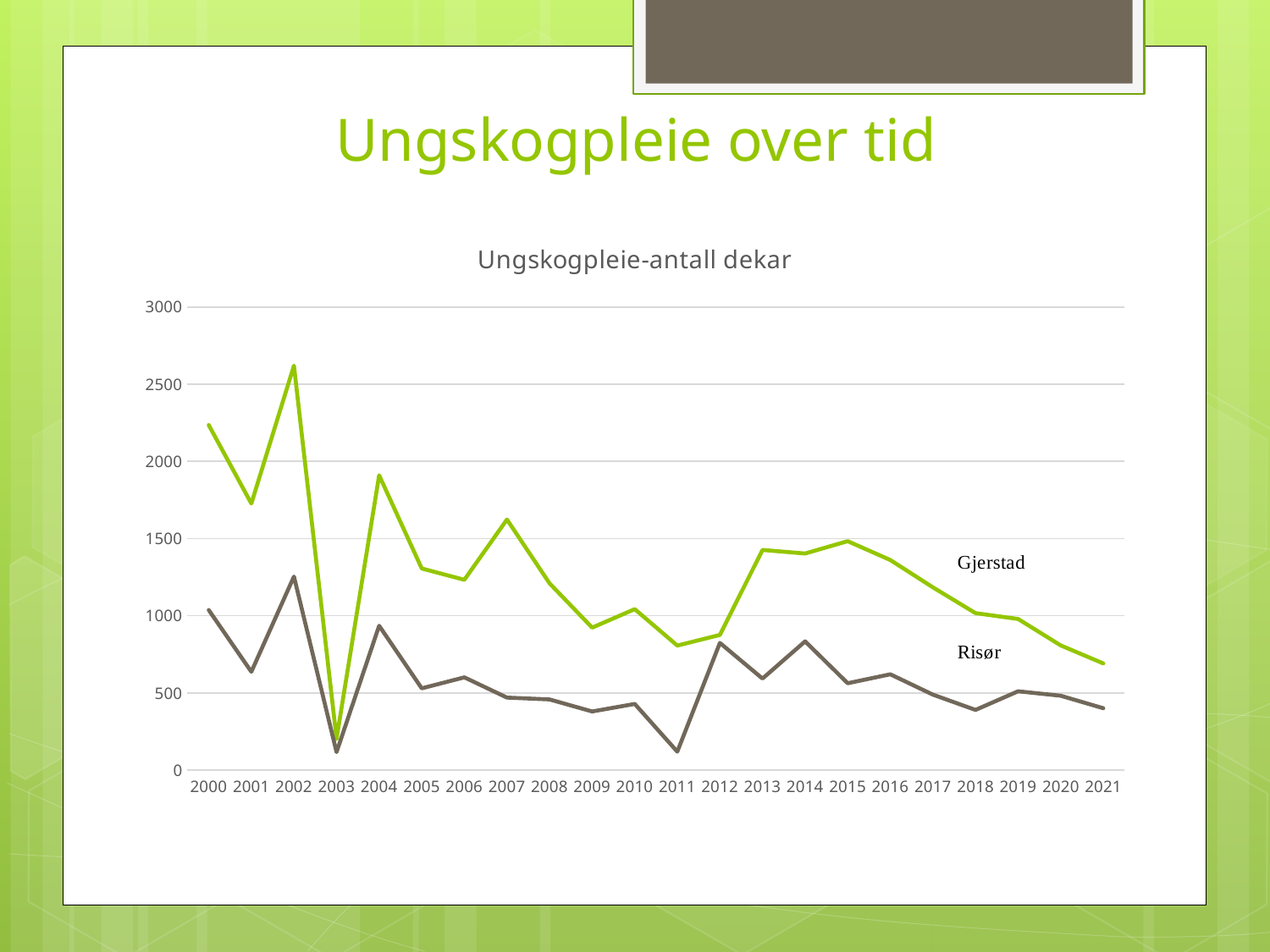
Is the value for Gjerstad in 2002 greater or less than 2500? greater Is the value for Risør in 2003 greater or less than 500? less In which year does the Risør line reach its highest value? 2002 What is the title of the chart? Ungskogpleie-antall dekar What kind of chart is shown on the slide? Line chart How many years are shown on the x axis of the chart? 22 Which series has the higher value in 2000, Gjerstad or Risør? Gjerstad In which year does the Gjerstad line reach its highest value? 2002 Is the value for Gjerstad in 2021 greater or less than 500? greater In which year does the Gjerstad line reach its lowest value? 2003 Does the Gjerstad line rise or fall from 2015 to 2021? Fall How many series are plotted in the chart? 2